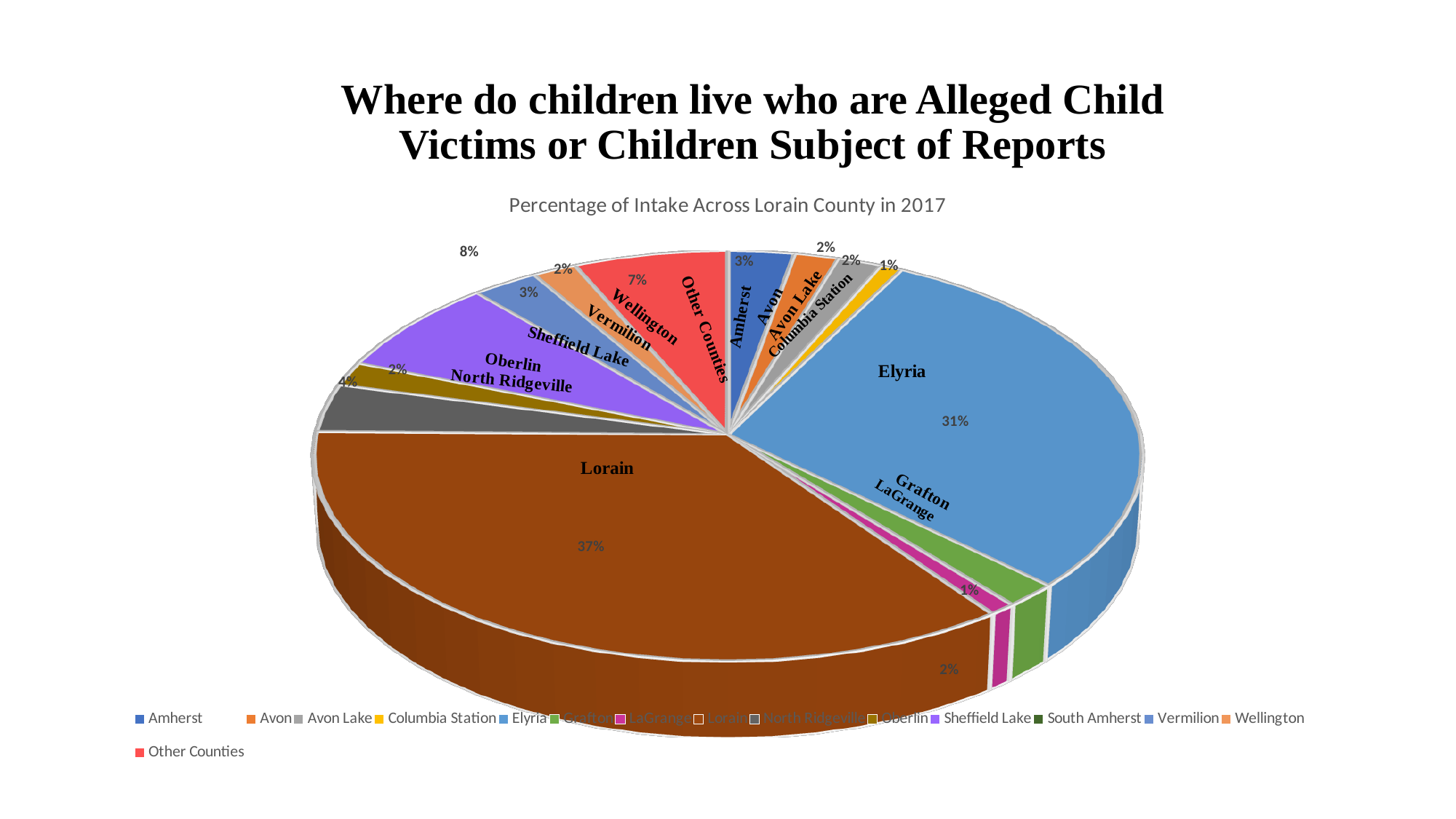
How many entries does the legend list? 15 What percentage of intake is attributed to Other Counties? 7% What is the subtitle of the chart? Percentage of Intake Across Lorain County in 2017 What percentage of intake is attributed to Sheffield Lake? 8% Which has a larger share of intake, Elyria or Sheffield Lake? Elyria Which location has the largest share of intake? Lorain What percentage of intake is attributed to North Ridgeville? 4% What percentage of intake is attributed to Lorain? 37% Which has a larger share of intake, Other Counties or North Ridgeville? Other Counties What type of chart is shown on the slide? Pie chart What percentage of intake is attributed to Elyria? 31% What is the difference in percentage points between Lorain and Elyria? 6 percentage points